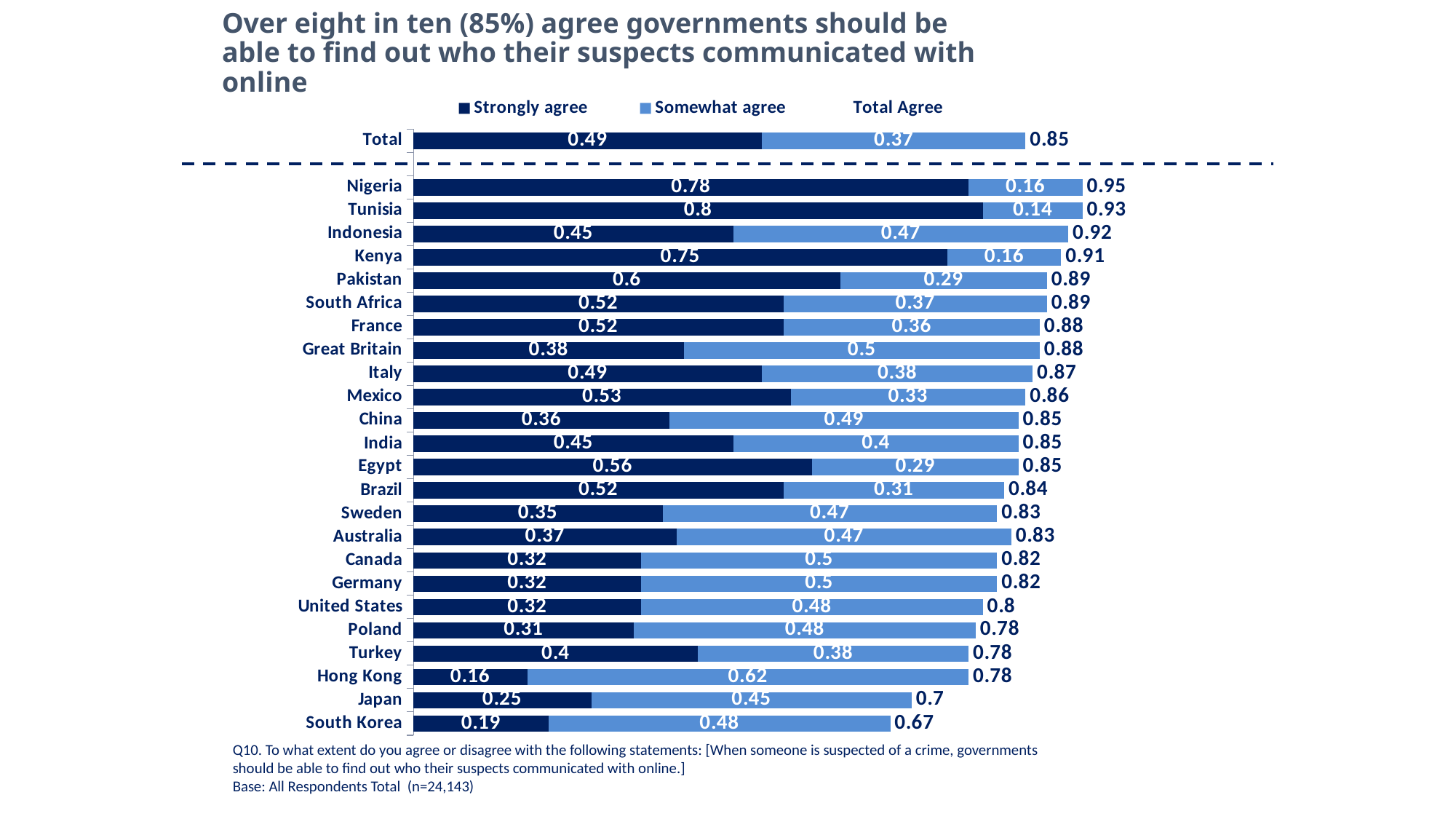
Which has a larger Strongly agree value, Kenya or Pakistan? Kenya What is the Total Agree value for the Total row? 0.85 What is the Somewhat agree value for Hong Kong? 0.62 Which country has the lowest Total Agree value? South Korea What kind of chart is shown on the slide? Stacked bar chart Which country has the highest Total Agree value? Nigeria What is the difference between the Total Agree values for Nigeria and South Korea? 0.28 What is the Total Agree value for Japan? 0.7 How many countries are listed below the dashed line in the chart? 24 How many entries does the legend list? 3 Which country has the lowest Strongly agree value? Hong Kong What is the Strongly agree value for Tunisia? 0.8